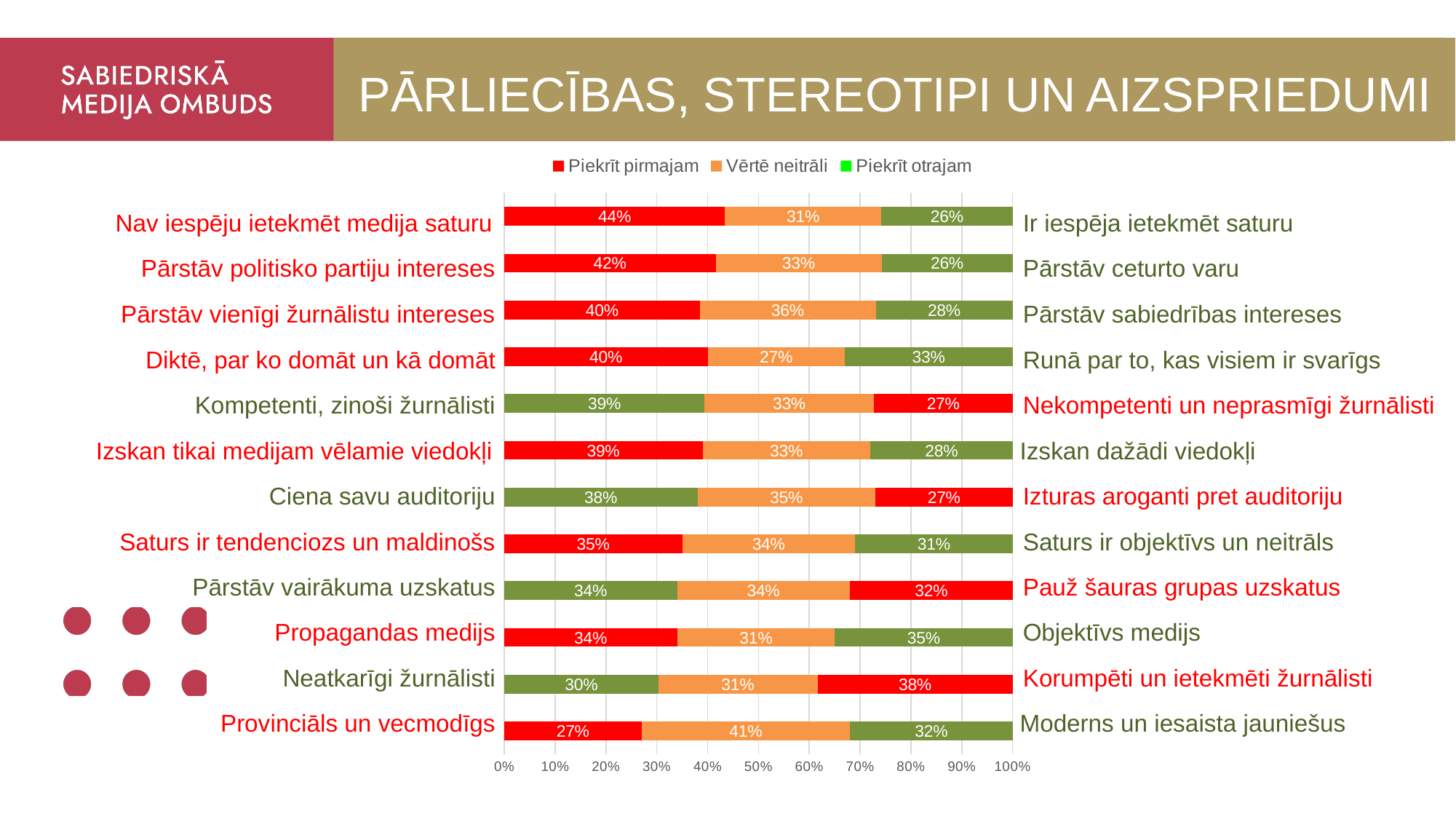
What is the red segment value for the row 'Nav iespēju ietekmēt medija saturu'? 44% Which row has the largest 'Vērtē neitrāli' (orange) share? Provinciāls un vecmodīgs / Moderns un iesaista jauniešus (41%) How many rows (statement pairs) are plotted in the chart? 12 How many series does the chart legend list? 3 Which row has the smallest 'Vērtē neitrāli' (orange) share? Diktē, par ko domāt un kā domāt / Runā par to, kas visiem ir svarīgs (27%) What is the red segment value for the row ending with 'Korumpēti un ietekmēti žurnālisti'? 38% What is the green segment value for the row ending with 'Objektīvs medijs'? 35% In the row 'Nav iespēju ietekmēt medija saturu / Ir iespēja ietekmēt saturu', what is the difference between the red segment and the green segment? 18 percentage points In the row 'Propagandas medijs / Objektīvs medijs', which segment is larger, the red one or the green one? The green one (35% vs 34%) What is the 'Vērtē neitrāli' (orange) value for the row 'Provinciāls un vecmodīgs / Moderns un iesaista jauniešus'? 41% What type of chart is shown on the slide? Stacked bar chart What colour represents 'Vērtē neitrāli' in the chart? Orange